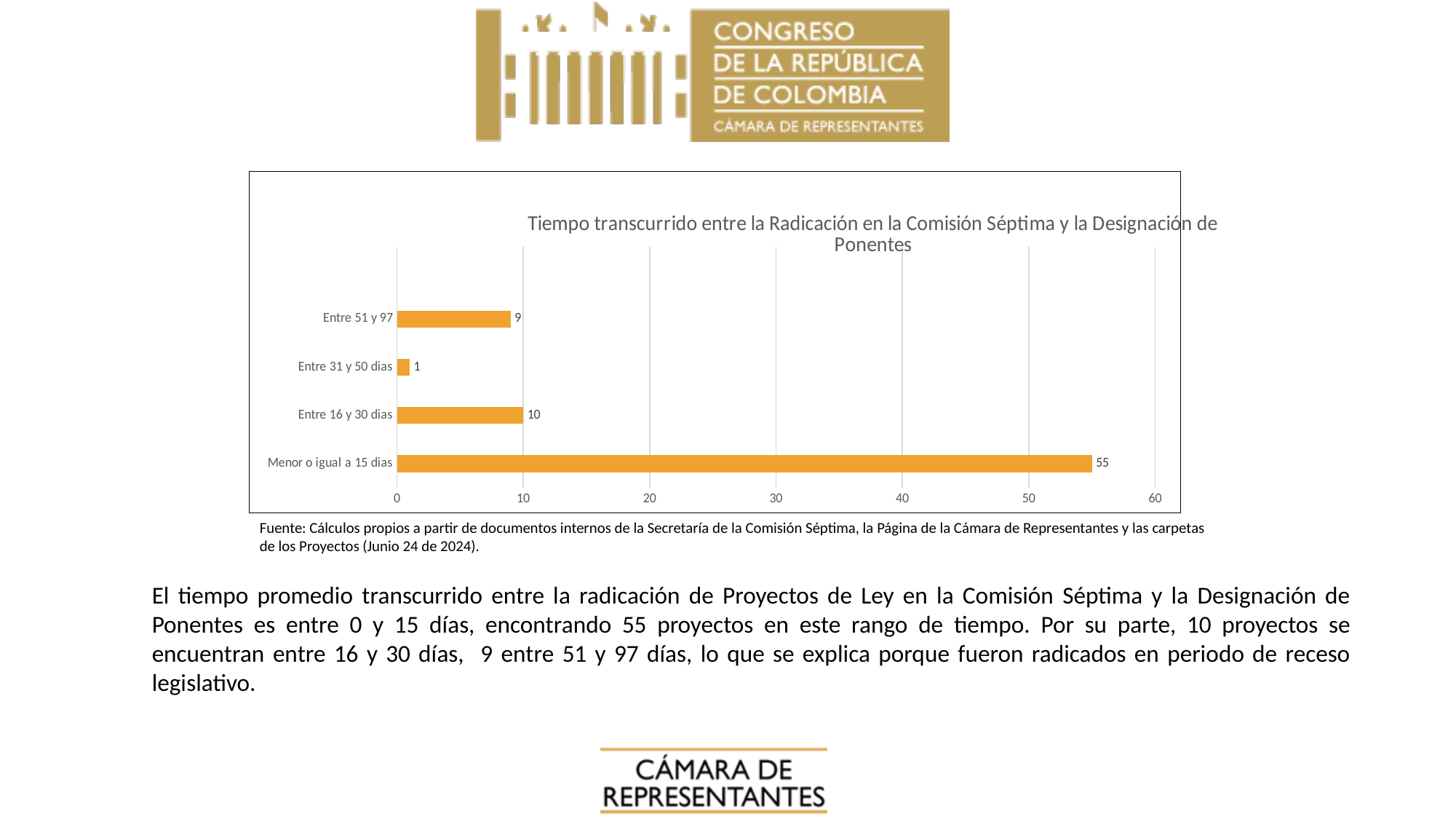
What is the value for 'Menor o igual a 15 dias'? 55 Is the value for 'Menor o igual a 15 dias' greater or less than 50? greater What is the value for 'Entre 51 y 97'? 9 What is the title of the chart? Tiempo transcurrido entre la Radicación en la Comisión Séptima y la Designación de Ponentes What kind of chart is shown on the slide? Bar chart How many categories are shown in the chart? 4 What is the difference between the values for 'Menor o igual a 15 dias' and 'Entre 16 y 30 dias'? 45 Which is larger, the value for 'Entre 16 y 30 dias' or the value for 'Entre 51 y 97'? Entre 16 y 30 dias Which category has the highest value? Menor o igual a 15 dias What is the value for 'Entre 16 y 30 dias'? 10 Which category has the lowest value? Entre 31 y 50 dias What is the value for 'Entre 31 y 50 dias'? 1